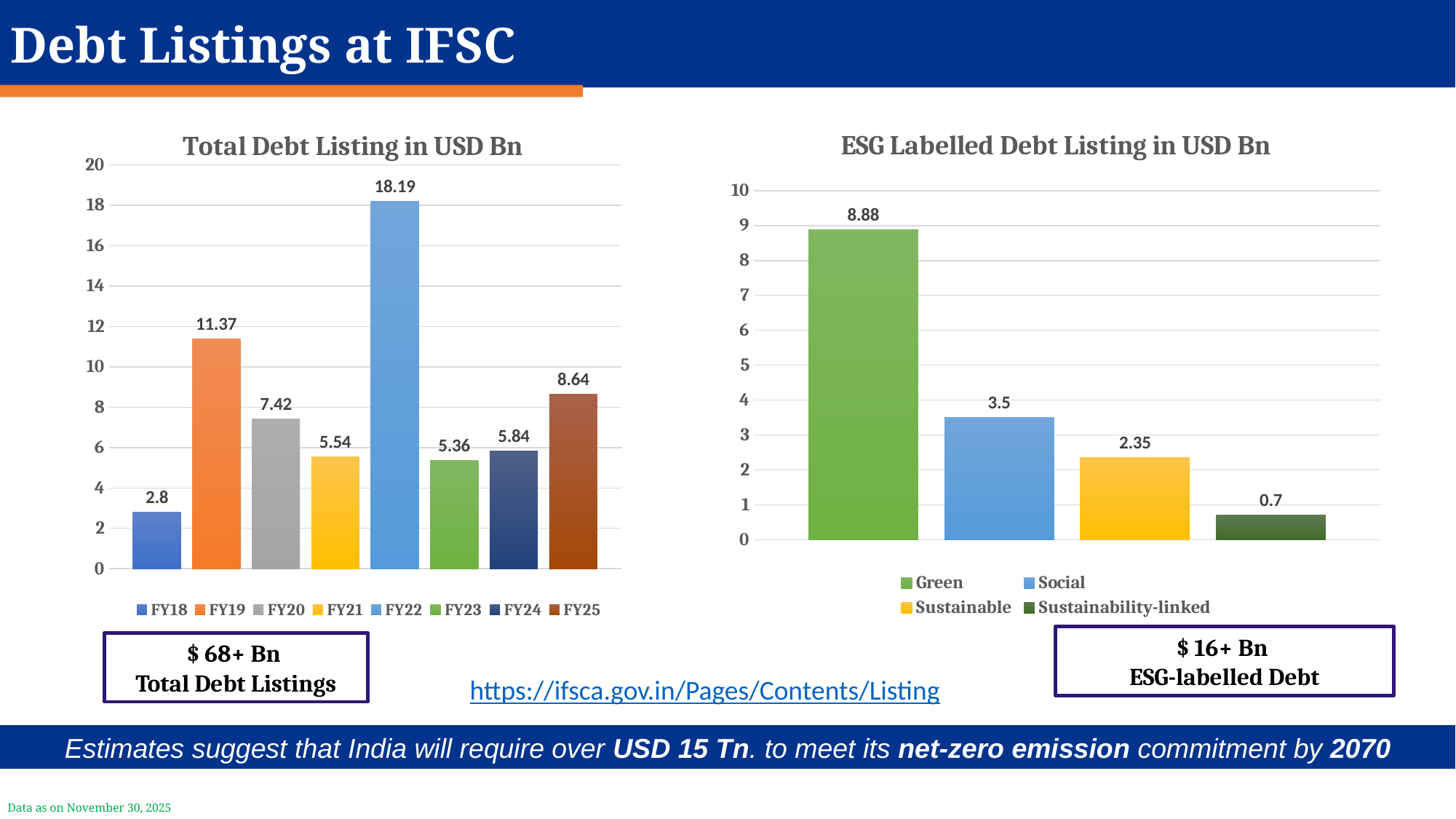
In the 'Total Debt Listing in USD Bn' chart, which fiscal year has the highest value? FY22 In the 'Total Debt Listing in USD Bn' chart, how many fiscal years are plotted? 8 In the 'Total Debt Listing in USD Bn' chart, is the value for FY25 greater or less than 10? less In the 'Total Debt Listing in USD Bn' chart, which fiscal year has the lowest value? FY18 In the 'Total Debt Listing in USD Bn' chart, what is the difference between the FY19 and FY20 values? 3.95 In the 'Total Debt Listing in USD Bn' chart, what is the value for FY22? 18.19 In the 'Total Debt Listing in USD Bn' chart, which is larger, the value for FY21 or FY24? FY24 In the 'ESG Labelled Debt Listing in USD Bn' chart, what is the difference between the Green and Sustainable values? 6.53 In the 'ESG Labelled Debt Listing in USD Bn' chart, which category has the lowest value? Sustainability-linked In the 'ESG Labelled Debt Listing in USD Bn' chart, what is the value for Social? 3.5 In the 'ESG Labelled Debt Listing in USD Bn' chart, how many entries does the legend list? 4 What type of chart is the 'ESG Labelled Debt Listing in USD Bn' chart? Bar chart